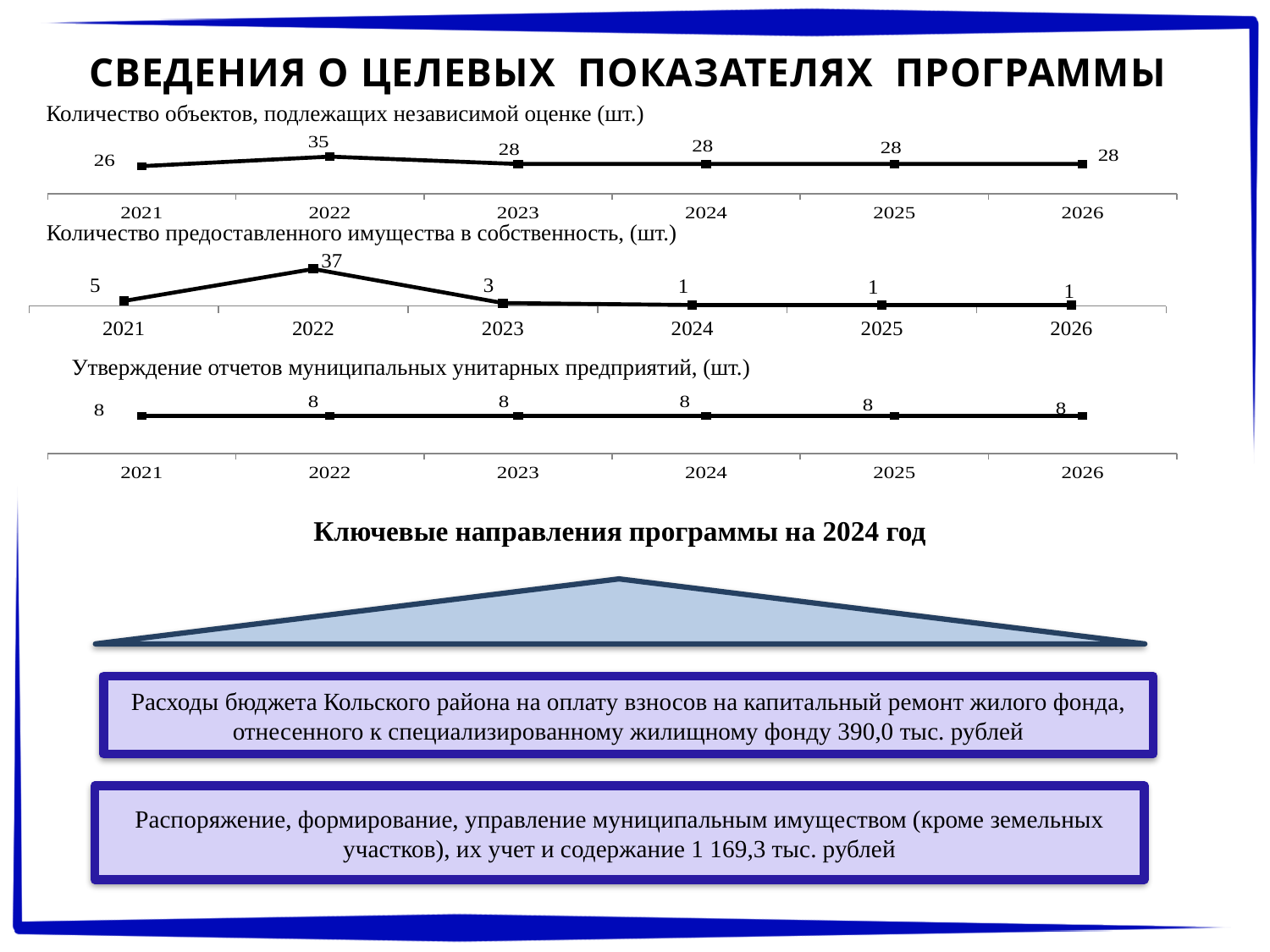
In the chart 'Количество объектов, подлежащих независимой оценке (шт.)', which year has the highest value? 2022 In the chart 'Количество предоставленного имущества в собственность, (шт.)', which year has the highest value? 2022 In the chart 'Утверждение отчетов муниципальных унитарных предприятий, (шт.)', what is the value for 2024? 8 In the chart 'Количество предоставленного имущества в собственность, (шт.)', is the value for 2021 or 2023 larger? 2021 How many years are plotted in the chart 'Утверждение отчетов муниципальных унитарных предприятий, (шт.)'? 6 In the chart 'Количество объектов, подлежащих независимой оценке (шт.)', what is the value for 2021? 26 What type of chart is 'Количество объектов, подлежащих независимой оценке (шт.)'? Line chart In the chart 'Количество предоставленного имущества в собственность, (шт.)', what is the difference between the values for 2022 and 2021? 32 In the chart 'Количество предоставленного имущества в собственность, (шт.)', what is the value for 2022? 37 In the chart 'Количество объектов, подлежащих независимой оценке (шт.)', what is the difference between the values for 2022 and 2021? 9 In the chart 'Количество предоставленного имущества в собственность, (шт.)', what is the value for 2023? 3 In the chart 'Количество объектов, подлежащих независимой оценке (шт.)', what is the value for 2022? 35